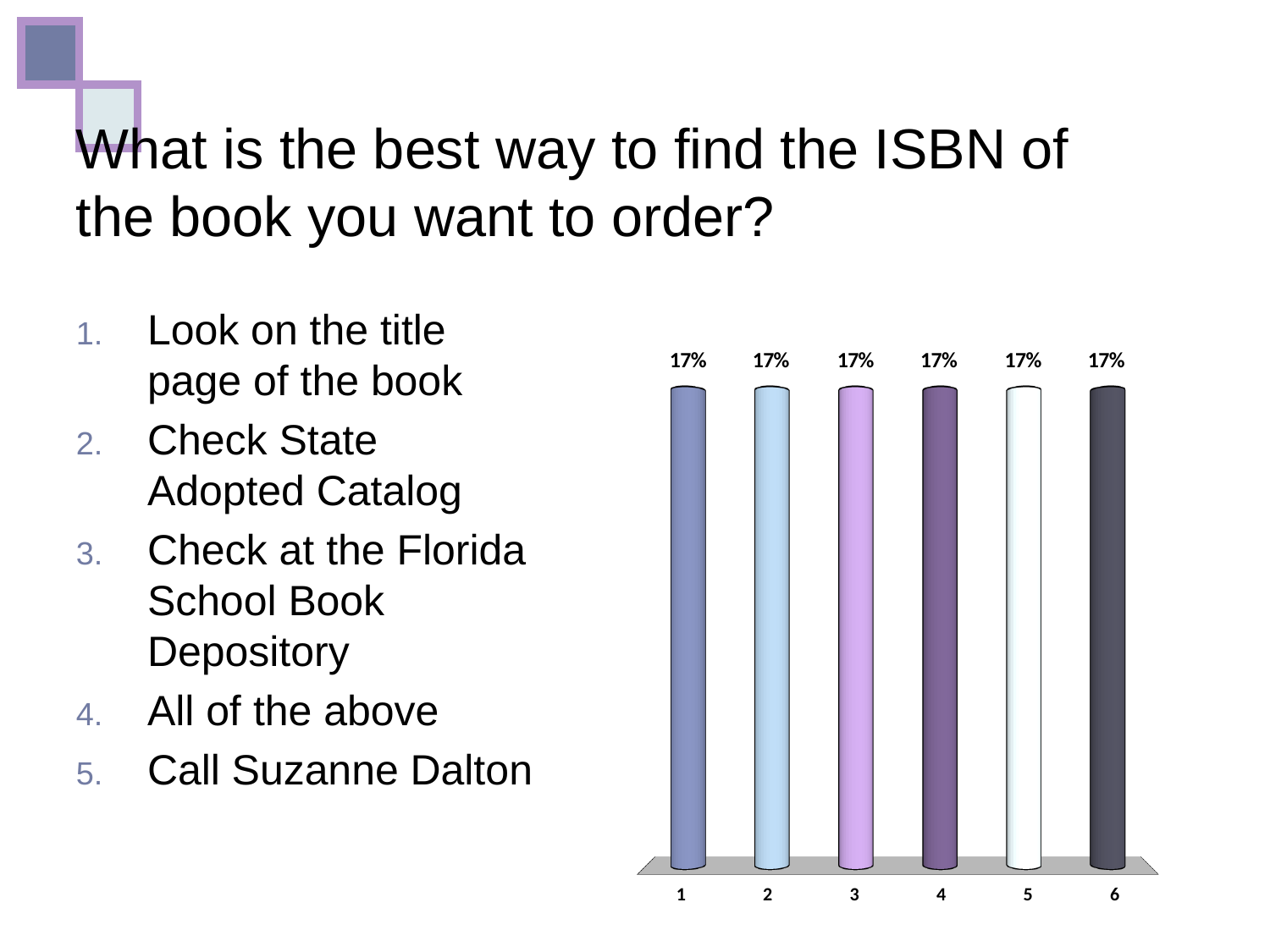
Do the values rise, fall, or stay the same across categories 1 to 6? stay the same What is the value shown for category 4 in the bar chart? 17% What is the label of the last category on the x axis? 6 What is the value shown for category 1 in the bar chart? 17% What colour is the bar for category 3? light purple What is the difference between the values for category 2 and category 5? 0% What is the value shown for category 6 in the bar chart? 17% How many bars are plotted in the chart? 6 Is the value for category 3 greater or less than 50%? less What kind of chart is shown on the slide? bar chart